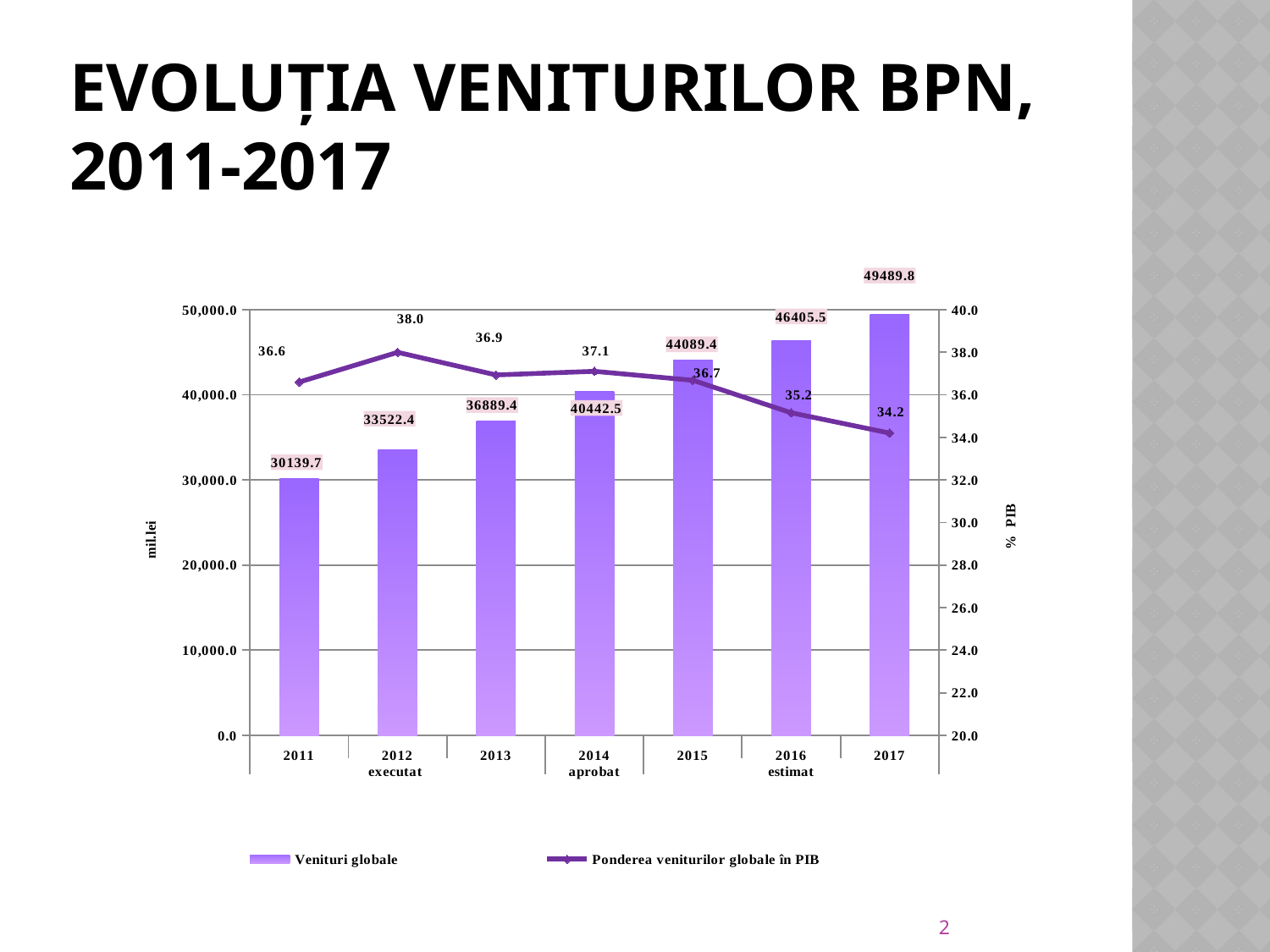
What is the difference between the Venituri globale values for 2017 and 2016? 3084.3 Which year has the lowest Ponderea veniturilor globale în PIB value? 2017 How many series does the legend list? 2 Is the Venituri globale value for 2014 greater or less than 40,000.0? greater Which year has the highest Venituri globale value? 2017 What is the value of Venituri globale for 2017? 49489.8 Which is larger, the Ponderea veniturilor globale în PIB value for 2013 or for 2014? 2014 What is the Ponderea veniturilor globale în PIB value for 2012? 38.0 What is the Ponderea veniturilor globale în PIB value for 2016? 35.2 What is the value of Venituri globale for 2011? 30139.7 How many years are shown on the x axis? 7 Does the Ponderea veniturilor globale în PIB line rise or fall from 2014 to 2017? fall